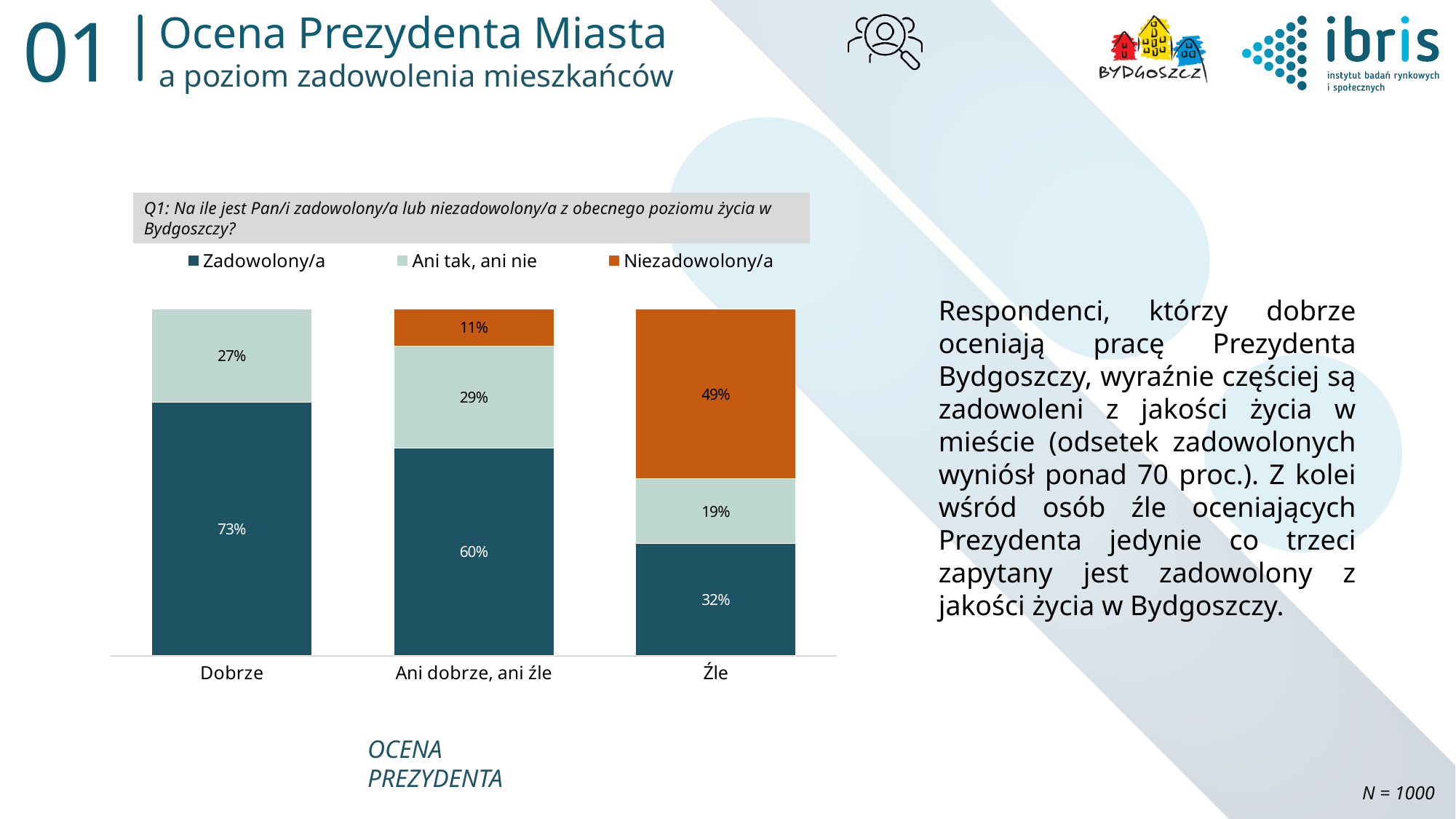
What percentage of respondents who rate the Mayor 'Dobrze' are 'Zadowolony/a'? 73% How many series does the legend list? 3 What is the 'Niezadowolony/a' value for the 'Ani dobrze, ani źle' category? 11% How many categories are shown on the x axis? 3 What is the difference between the 'Zadowolony/a' values for 'Dobrze' and 'Źle'? 41 percentage points Which is larger: the 'Ani tak, ani nie' value for 'Dobrze' or for 'Źle'? Dobrze What kind of chart is shown on the slide? Stacked bar chart What is the 'Ani tak, ani nie' value for the 'Ani dobrze, ani źle' category? 29% Which category has the highest 'Zadowolony/a' share? Dobrze Which category has the lowest 'Zadowolony/a' share? Źle What is the total of the stacked bar for 'Ani dobrze, ani źle'? 100% What is the 'Niezadowolony/a' value for the 'Źle' category? 49%